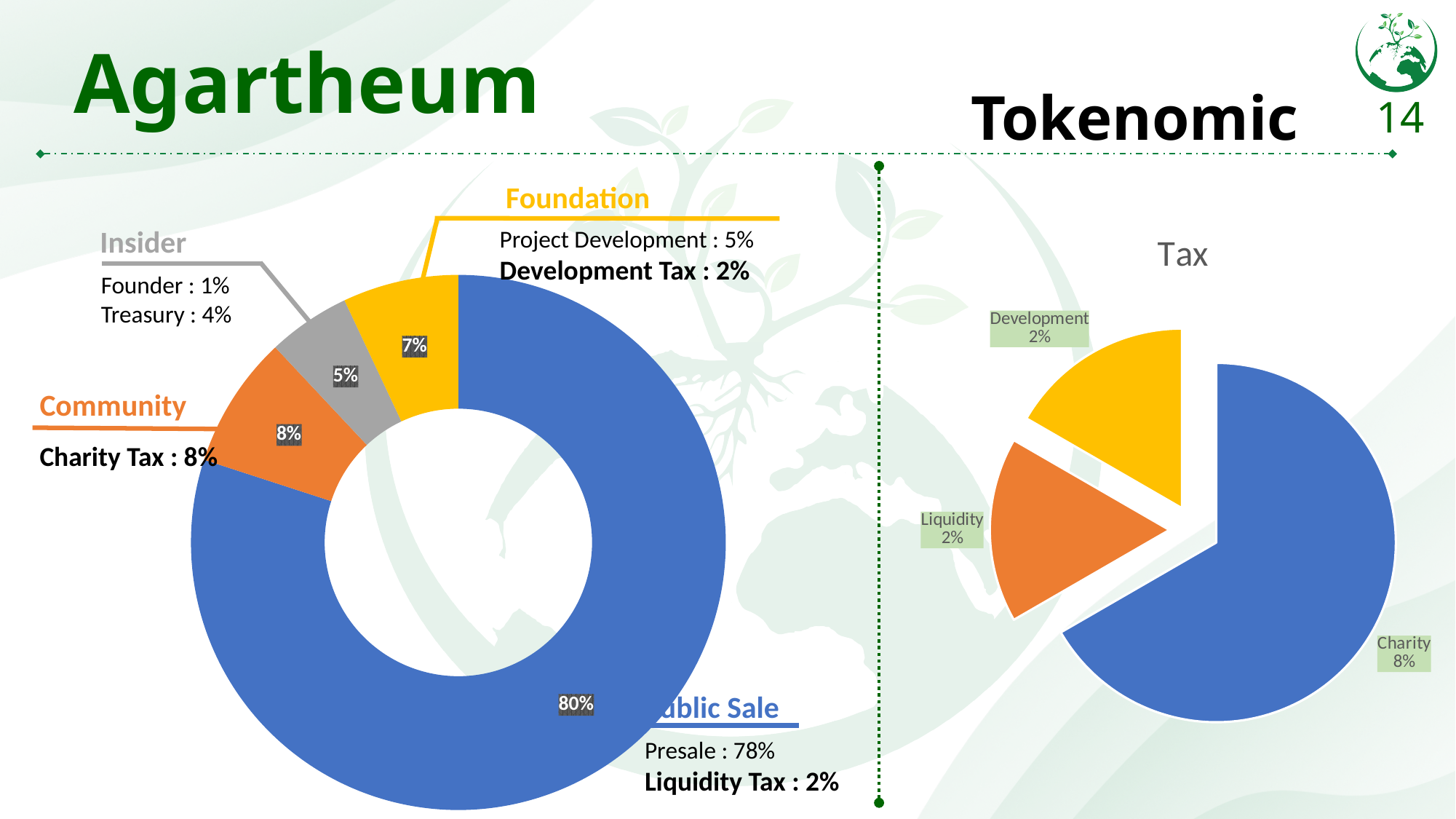
On the left donut chart, which is larger, Foundation or Community? Community On the left donut chart, what is the difference between the Public Sale and Community percentages? 72% On the left donut chart, what percentage is shown for Foundation? 7% On the Tax chart, which slice is the largest? Charity On the Tax chart, what percentage is shown for Charity? 8% What kind of chart is the chart titled Tax? Pie chart On the left donut chart, which segment is the smallest? Insider On the left donut chart, which segment is the largest? Public Sale On the left donut chart, what percentage is shown for Insider? 5% How many segments does the left donut chart have? 4 On the left donut chart, what percentage is shown for Public Sale? 80% How many slices does the Tax chart have? 3